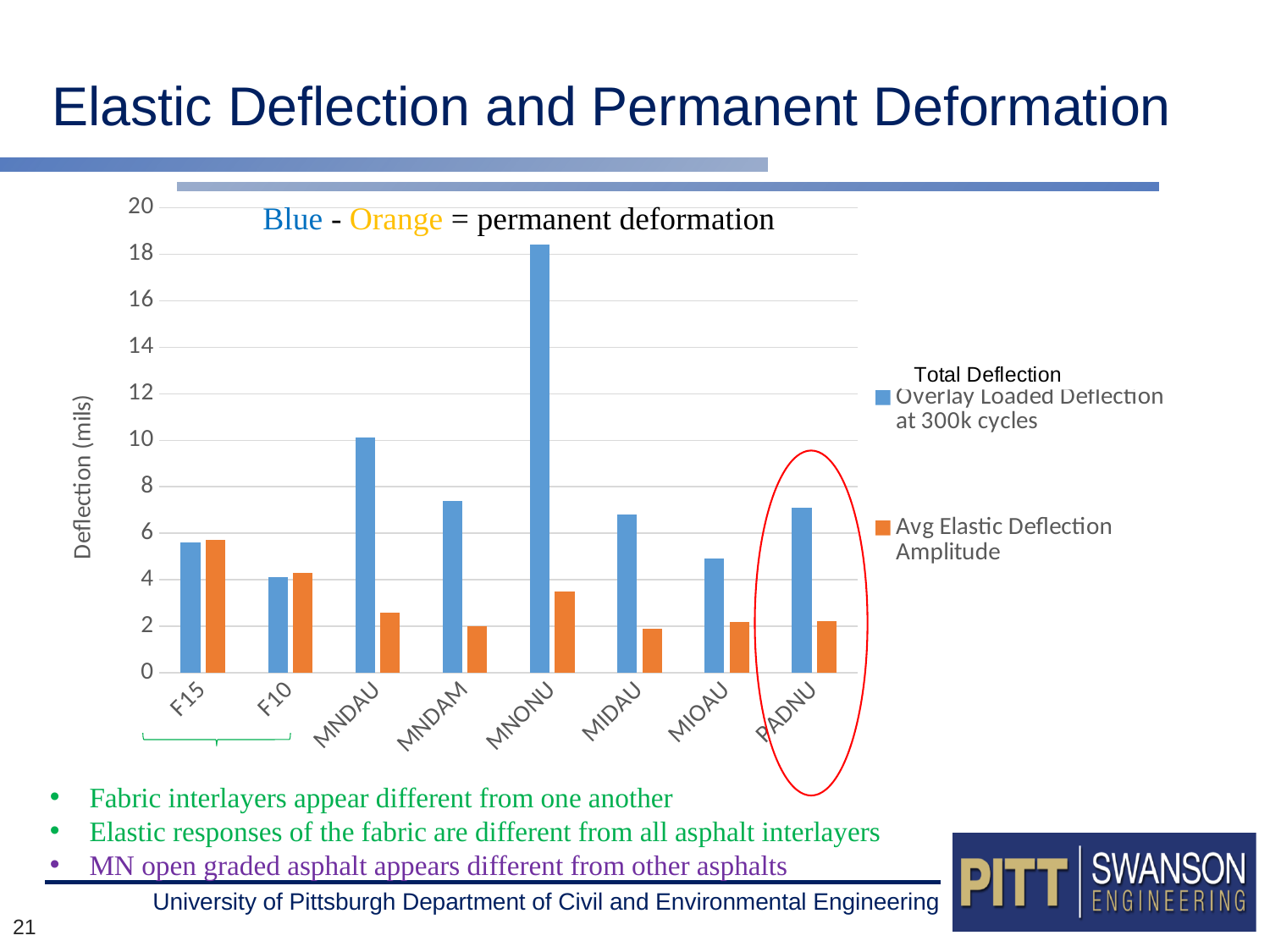
Which category has the highest Overlay Loaded Deflection at 300k cycles? MNONU Which category has the lowest Overlay Loaded Deflection at 300k cycles? F10 Is the Overlay Loaded Deflection at 300k cycles for MNONU greater or less than 16? greater What kind of chart is shown on the slide? bar chart How many series does the chart's legend list? 2 Is the Avg Elastic Deflection Amplitude for MNDAM greater or less than 4? less What is the label of the chart's vertical axis? Deflection (mils) How many categories are shown along the x axis of the chart? 8 Is the Overlay Loaded Deflection at 300k cycles for MNDAU greater or less than 8? greater Which has a larger Overlay Loaded Deflection at 300k cycles, MNDAU or MNDAM? MNDAU Which colour represents the Avg Elastic Deflection Amplitude series in the chart? orange Which category has the highest Avg Elastic Deflection Amplitude? F15